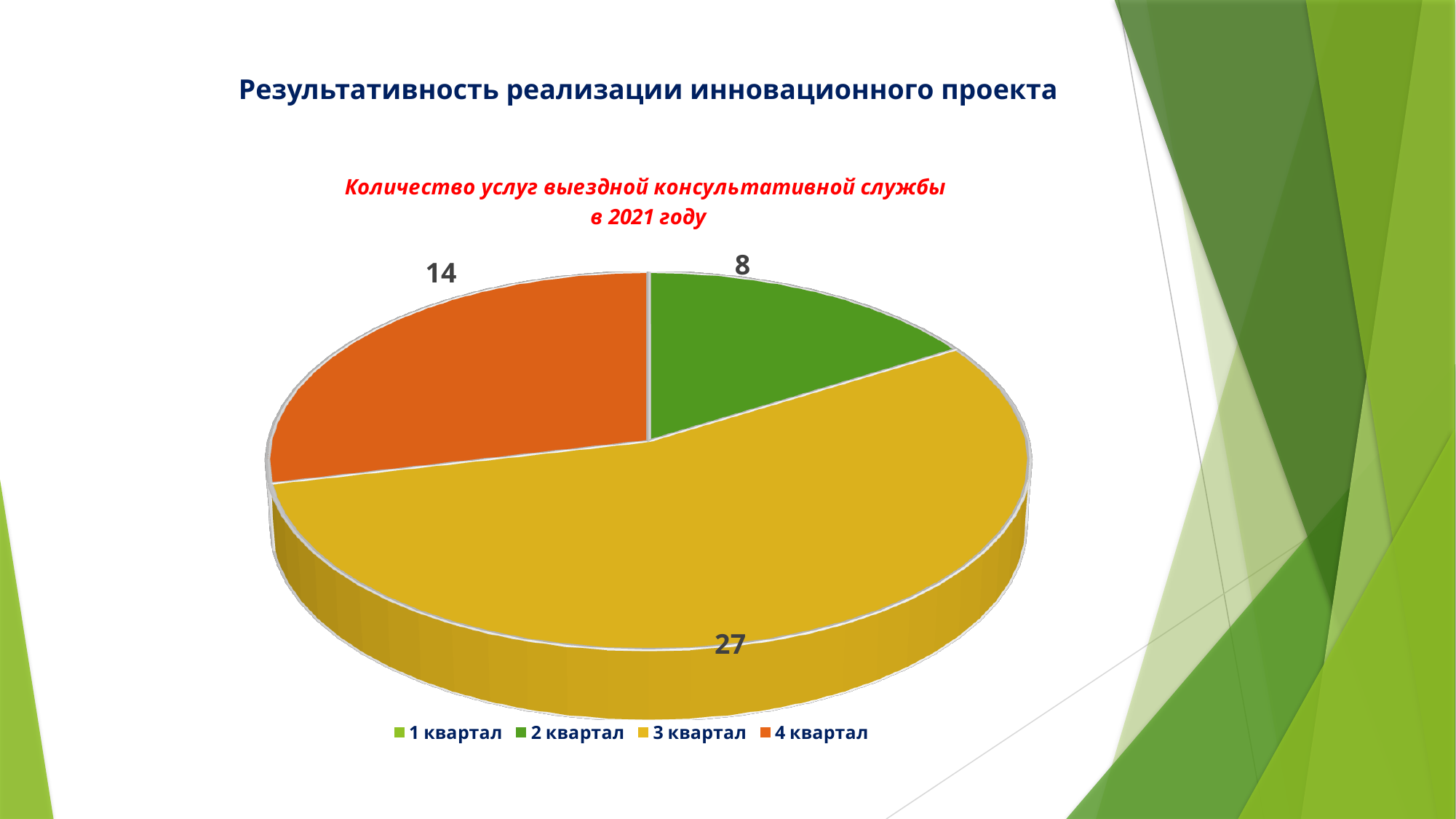
What kind of chart is shown on the slide? pie chart Which quarter has the largest slice in the pie chart? 3 квартал What is the value for 3 квартал in the pie chart? 27 What is the value for 2 квартал in the pie chart? 8 What is the difference between the values for 4 квартал and 2 квартал? 6 What is the value for 4 квартал in the pie chart? 14 What is the title of the pie chart? Количество услуг выездной консультативной службы в 2021 году How many entries does the legend of the pie chart list? 4 What colour is the slice for 3 квартал in the pie chart? yellow Which is larger, the value for 4 квартал or the value for 2 квартал? 4 квартал Which labelled slice has the smallest value in the pie chart? 2 квартал What is the difference between the values for 3 квартал and 4 квартал? 13